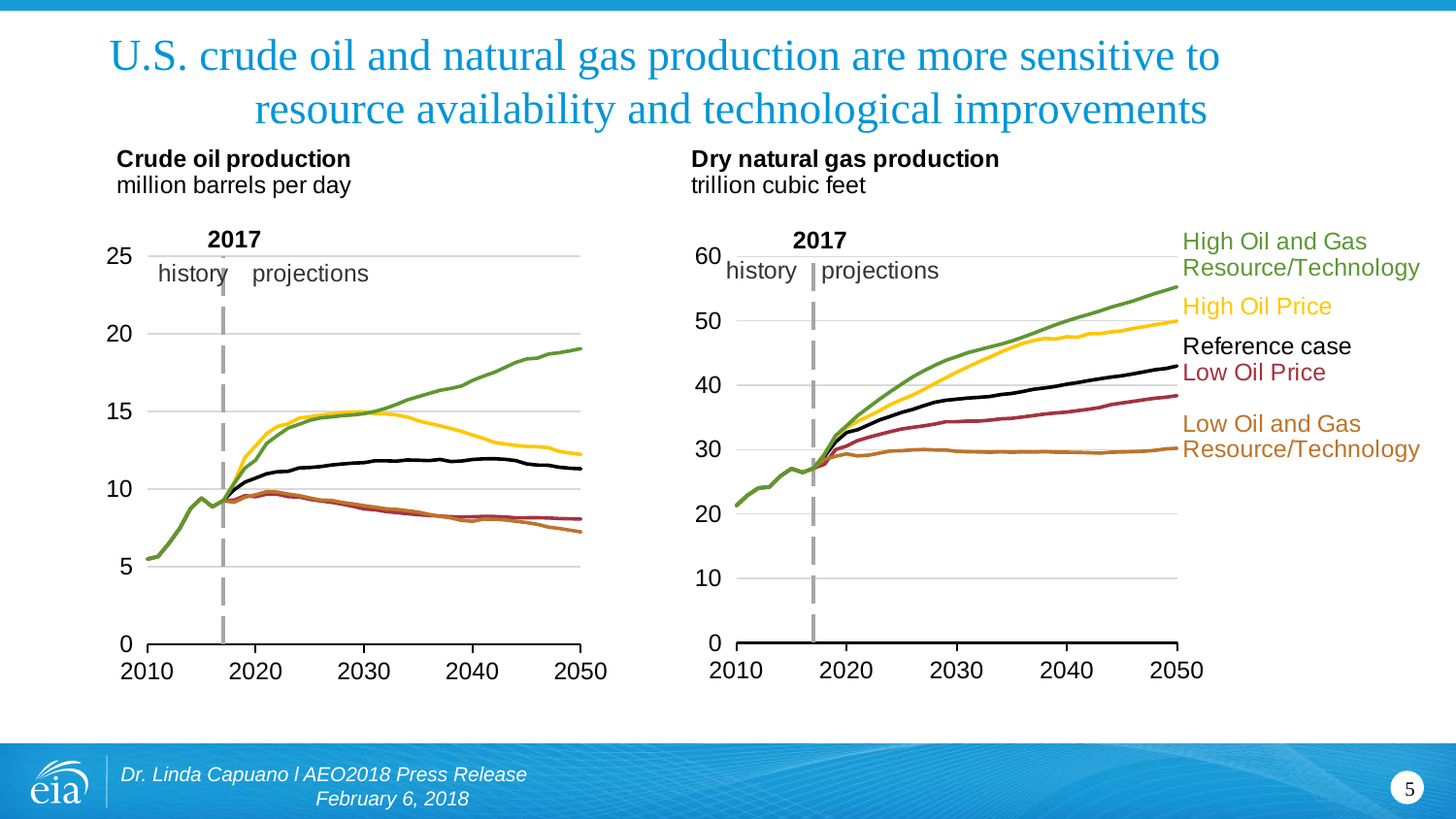
How many scenarios does the legend on the Dry natural gas production chart list? 5 In the Crude oil production chart, which is higher in 2050: the High Oil Price scenario or the Reference case? High Oil Price What kind of chart is the Crude oil production chart? line chart In the Crude oil production chart, is the Reference case value in 2050 greater or less than 10? greater What unit is used on the Dry natural gas production chart? trillion cubic feet In the Crude oil production chart, does the High Oil Price scenario rise or fall between 2030 and 2050? fall In the Dry natural gas production chart, is the Low Oil and Gas Resource/Technology value in 2050 greater or less than 40? less In the Dry natural gas production chart, which scenario has the highest value in 2050? High Oil and Gas Resource/Technology In the Crude oil production chart, is the High Oil and Gas Resource/Technology value in 2050 greater or less than 15? greater In the Crude oil production chart, which scenario has the lowest value in 2050? Low Oil and Gas Resource/Technology In the Dry natural gas production chart, does the Reference case rise or fall over the projection period from 2017 to 2050? rise